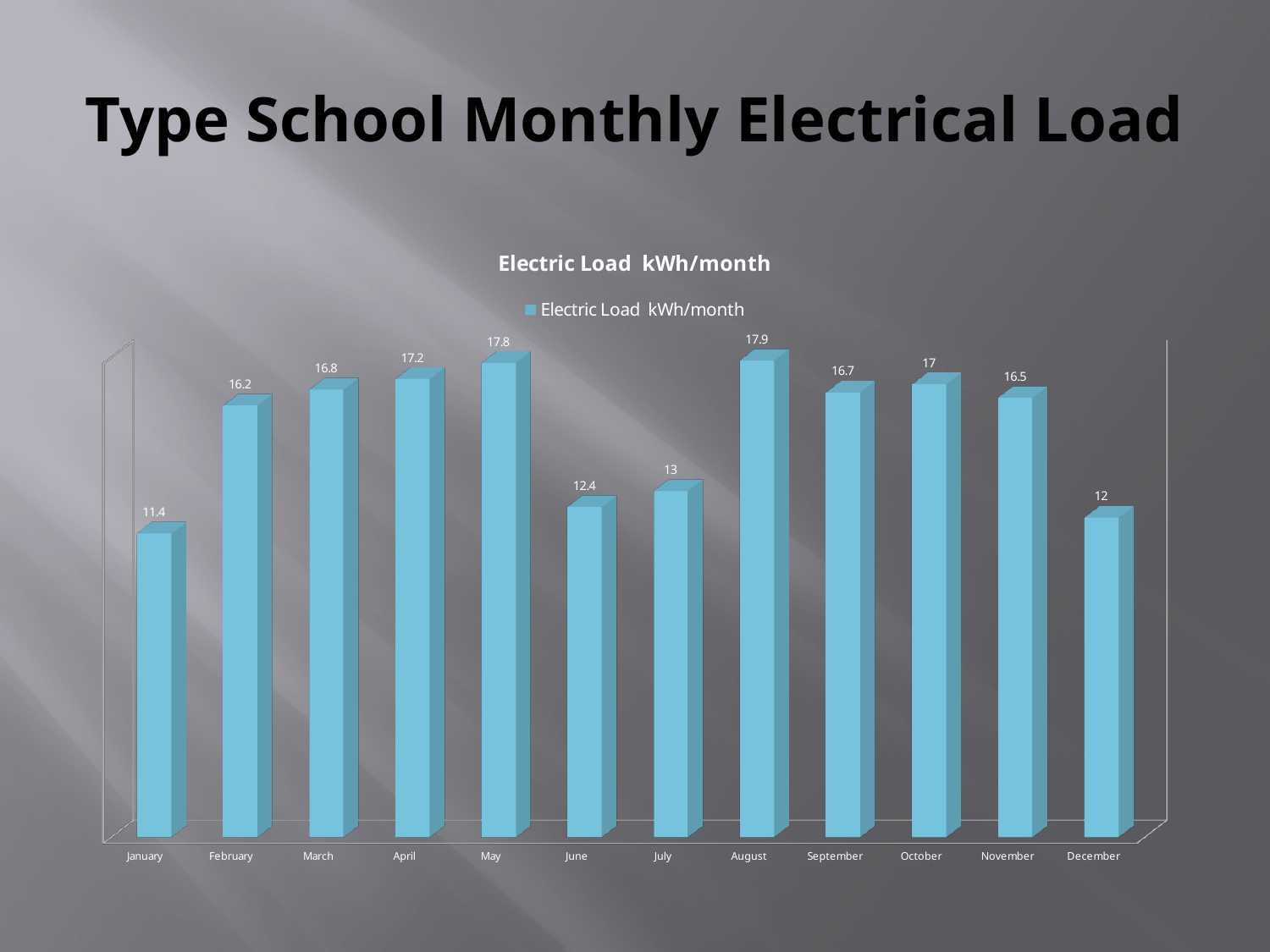
What kind of chart is shown on the slide? Bar chart Which month has the lowest electric load? January Which month has a larger electric load, February or March? March Which month has the highest electric load? August Does the electric load rise or fall from January to May? Rise What is the difference between the electric load in May and in June? 5.4 How many months are shown on the chart? 12 What is the electric load for August? 17.9 What is the title of the chart? Electric Load kWh/month What is the electric load for January? 11.4 What is the electric load for December? 12 How many series does the legend list? 1